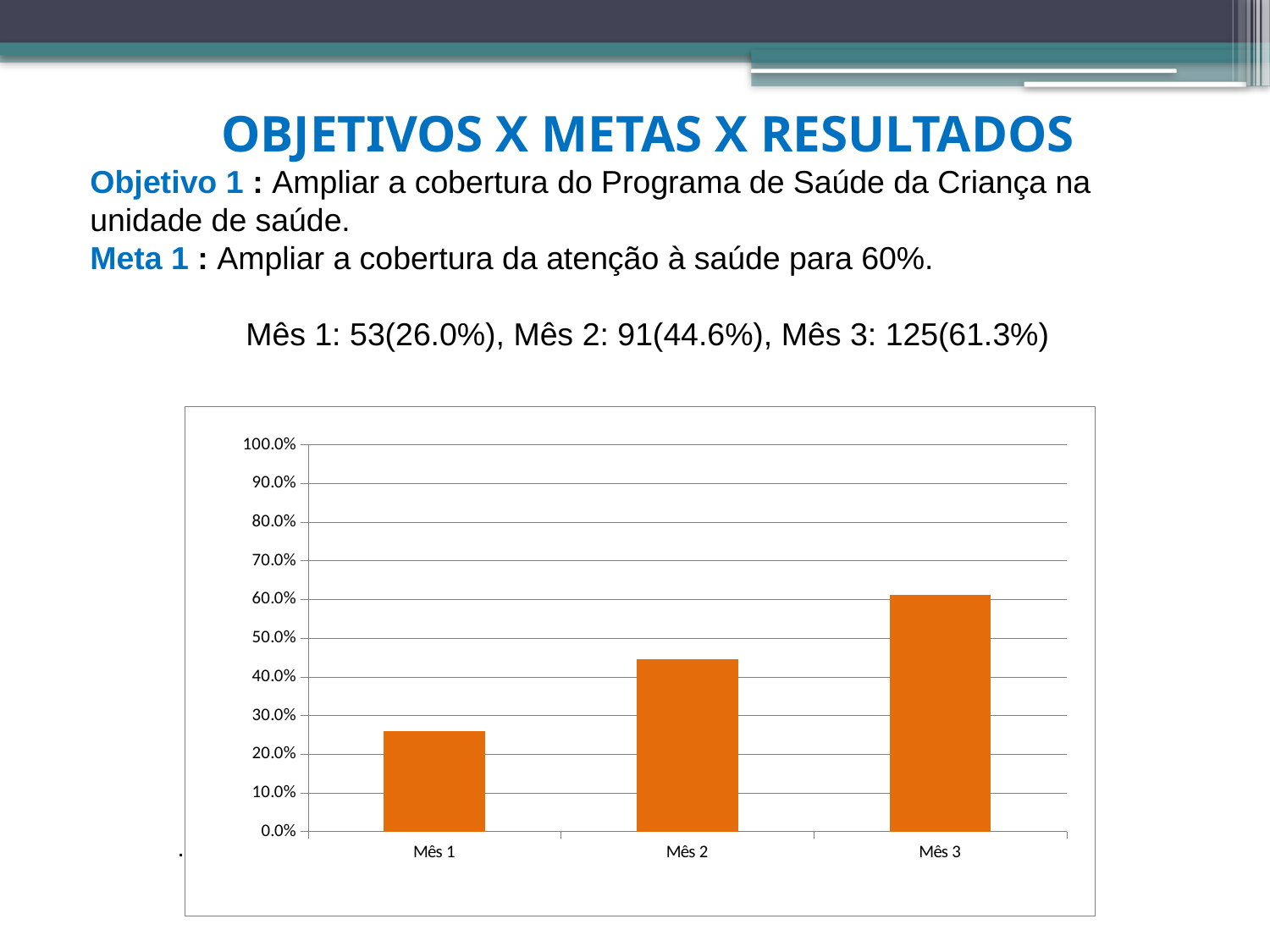
Which month has the highest bar in the chart? Mês 3 Is the value for Mês 1 greater or less than 30.0%? less Which month has the lowest bar in the chart? Mês 1 According to the text above the chart, what percentage is shown for Mês 1? 26.0% Which is larger, the value for Mês 2 or the value for Mês 3? Mês 3 Is the value for Mês 2 greater or less than 40.0%? greater Do the values rise or fall from Mês 1 to Mês 3? rise Is the value for Mês 3 greater or less than 60.0%? greater How many bars (categories) does the chart show? 3 What is the highest value shown on the vertical axis of the chart? 100.0% According to the text above the chart, what percentage is shown for Mês 3? 61.3% What kind of chart is shown on the slide? bar chart